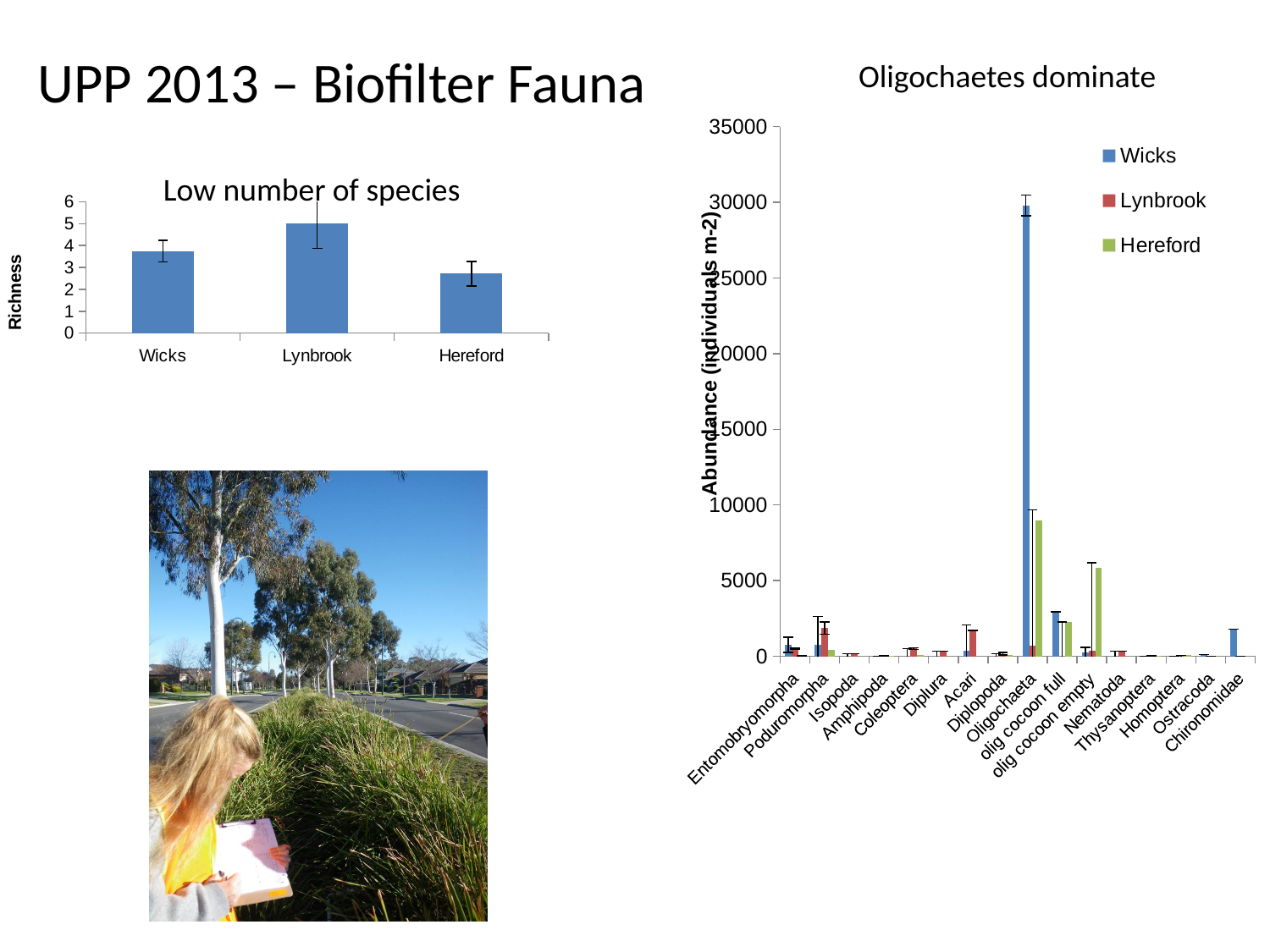
In the "Oligochaetes dominate" chart, which is larger for olig cocoon empty: Lynbrook or Hereford? Hereford What kind of chart is the "Oligochaetes dominate" chart? bar chart In the "Oligochaetes dominate" chart, is the Wicks value for Oligochaeta greater or less than 25000? greater In the "Oligochaetes dominate" chart, how many taxa categories are shown on the x axis? 16 In the "Low number of species" chart, which site has the lowest richness? Hereford In the "Oligochaetes dominate" chart, how many series does the legend list? 3 In the "Low number of species" chart, how many sites are shown on the x axis? 3 In the "Low number of species" chart, is the richness for Wicks greater or less than 3? greater In the "Low number of species" chart, which site has the highest richness? Lynbrook In the "Low number of species" chart, what is the label of the y axis? Richness In the "Oligochaetes dominate" chart, is the Hereford value for Oligochaeta greater or less than 10000? less In the "Oligochaetes dominate" chart, which category has the highest abundance for Wicks? Oligochaeta